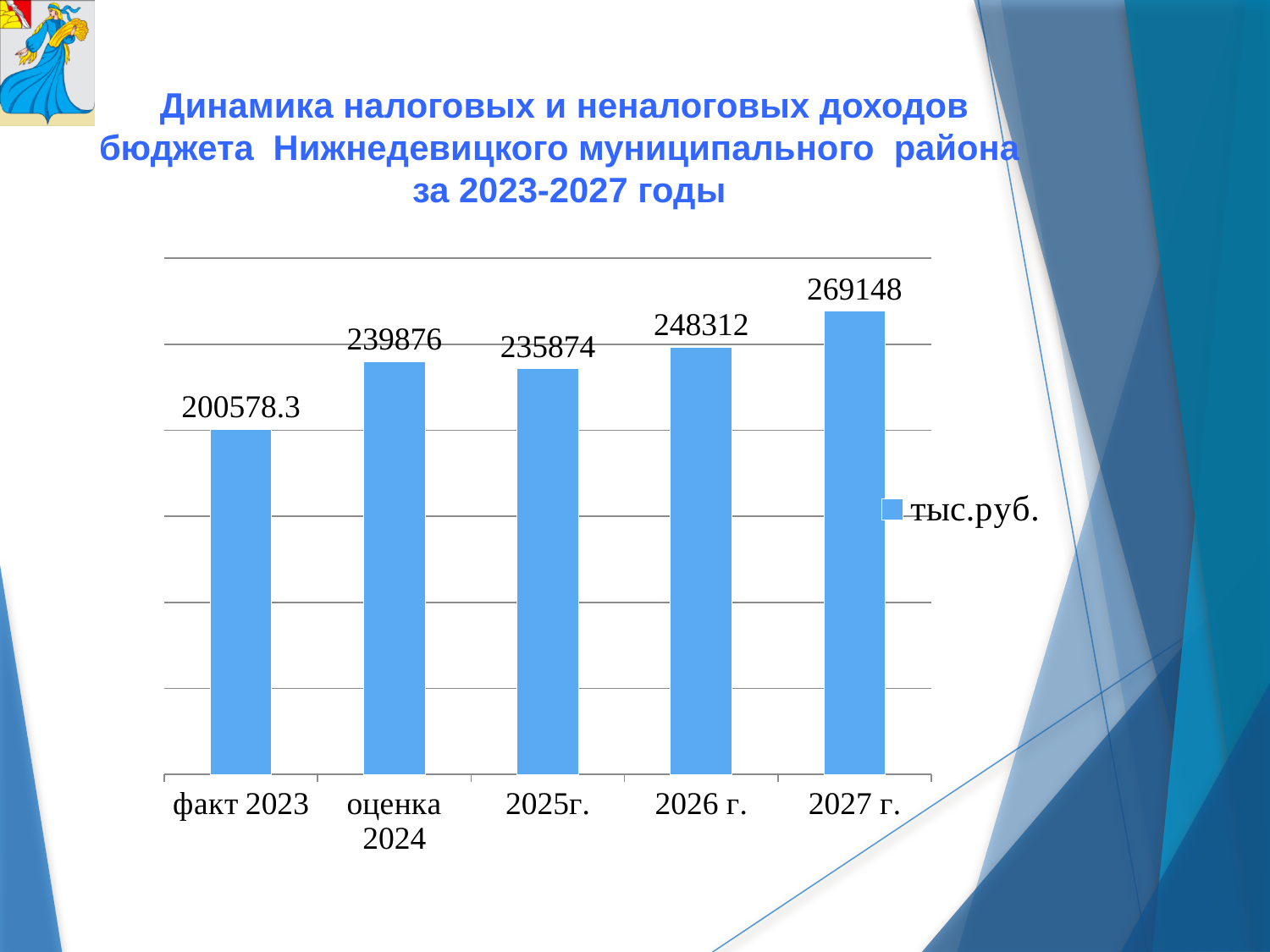
What is the value for 2025г.? 235874 What is the value for оценка 2024? 239876 What is the difference between the values for 2027 г. and 2026 г.? 20836 What is the value for факт 2023? 200578.3 Which category has the lowest value? факт 2023 Which category has the highest value? 2027 г. How many categories are shown on the x axis? 5 What is the legend entry for the series? тыс.руб. What is the value for 2027 г.? 269148 Which is larger, the value for оценка 2024 or the value for 2025г.? оценка 2024 What is the value for 2026 г.? 248312 What kind of chart is shown on the slide? bar chart